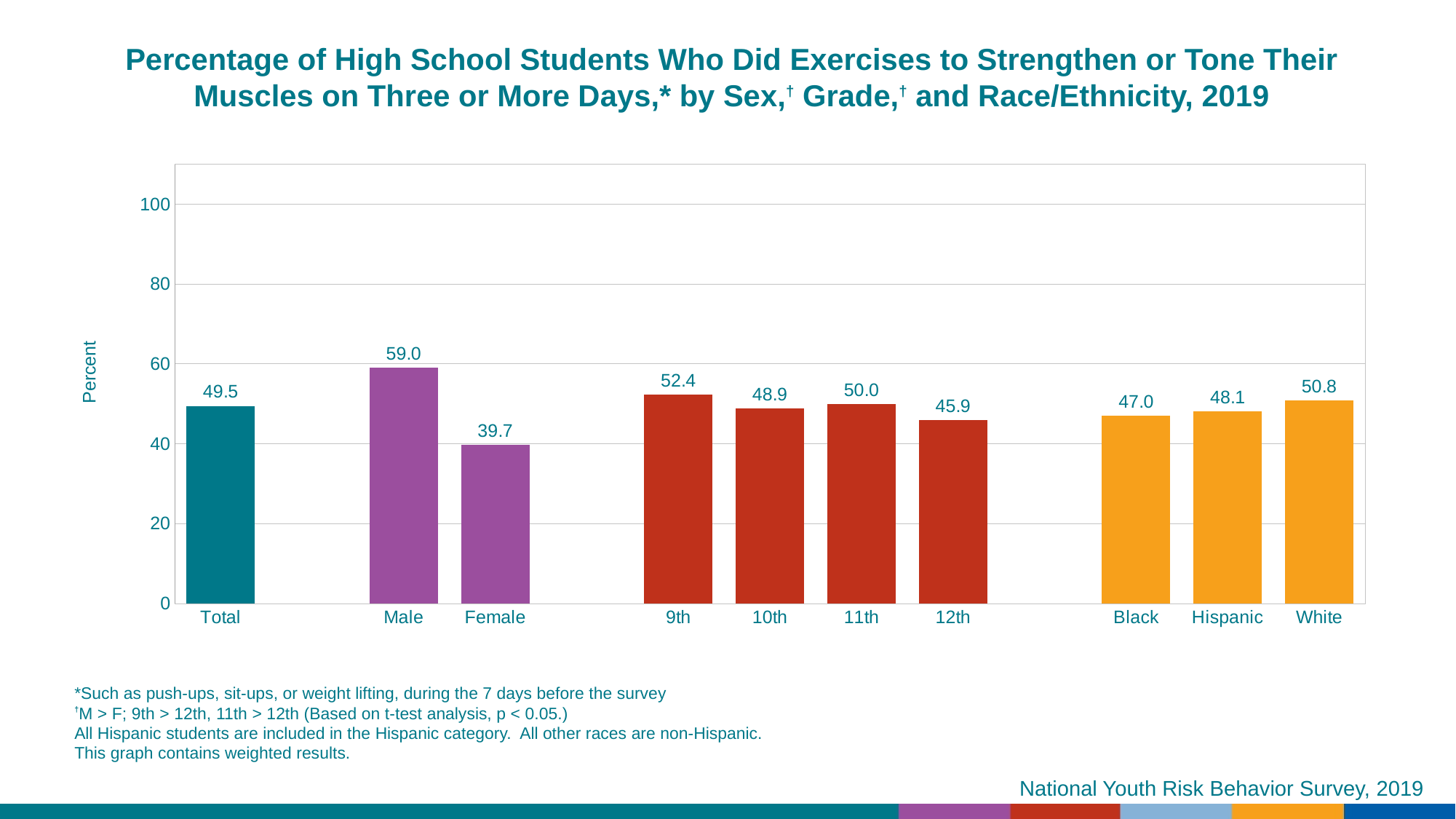
What is the value for Male? 59.0 What is the value for 12th grade? 45.9 Which is larger, the value for White or the value for Black? White What kind of chart is shown on the slide? Bar chart Which category has the highest value? Male Which category has the lowest value? Female What is the difference between the values for 9th and 12th grade? 6.5 What is the value for Female? 39.7 How many categories are plotted on the chart? 10 What is the label on the vertical axis? Percent What is the difference between the values for Male and Female? 19.3 What is the value for Hispanic students? 48.1